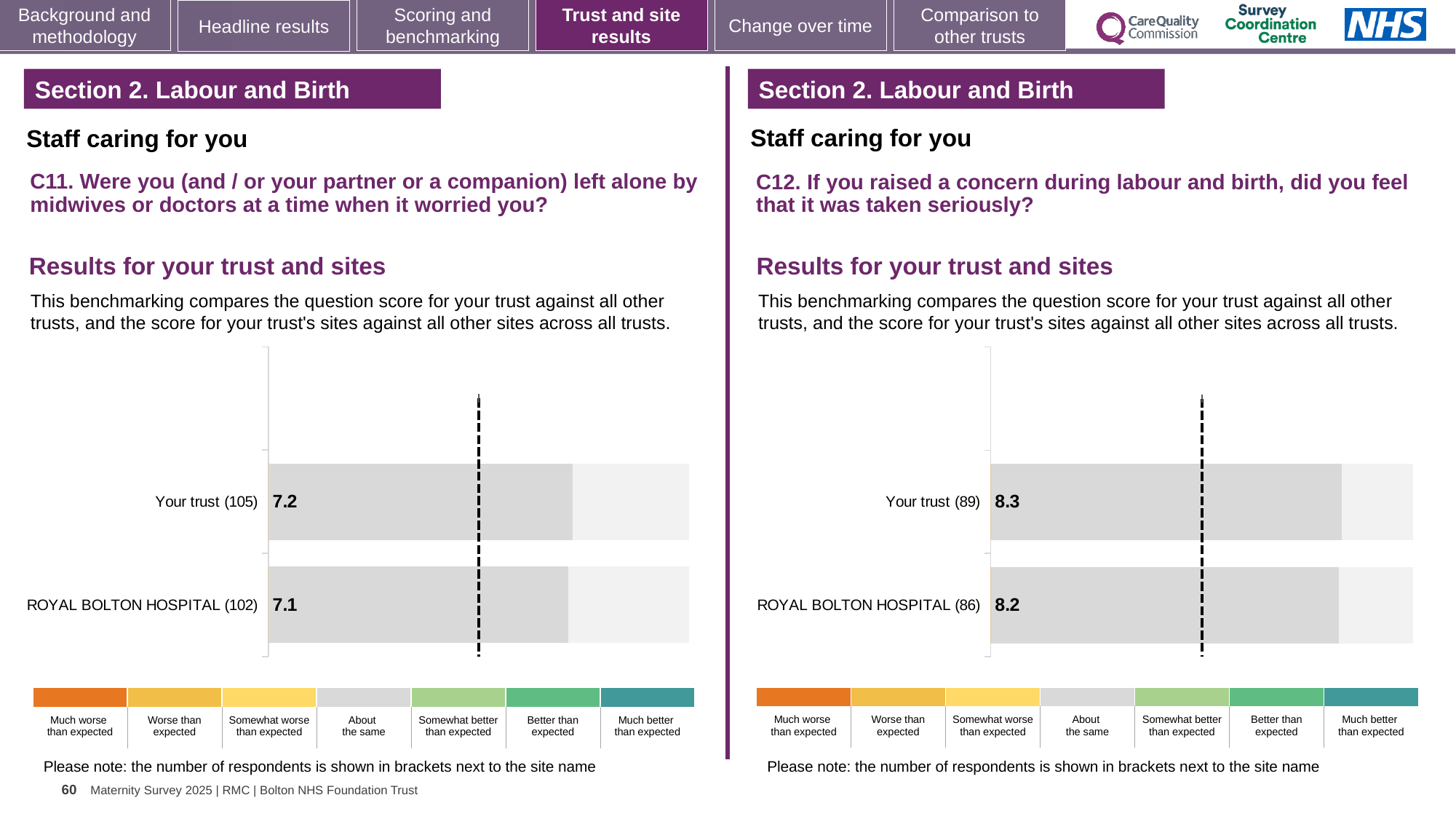
In the C11 chart on the left, how many respondents are shown in brackets for Your trust? 105 In the C12 chart on the right, what is the score for ROYAL BOLTON HOSPITAL? 8.2 In the C12 chart on the right, which row has the lower score? ROYAL BOLTON HOSPITAL In the C11 chart on the left, what is the score for Your trust? 7.2 How many bars are plotted in the C12 chart on the right? 2 In the C12 chart on the right, is the score for Your trust larger or smaller than the score for ROYAL BOLTON HOSPITAL? larger In the C11 chart on the left, what is the score for ROYAL BOLTON HOSPITAL? 7.1 In the C11 chart on the left, what is the difference between the Your trust score and the ROYAL BOLTON HOSPITAL score? 0.1 What type of chart is used in the C11 chart on the left? bar chart In the C12 chart on the right, what is the score for Your trust? 8.3 In the C11 chart on the left, which row has the higher score? Your trust In the C12 chart on the right, how many respondents are shown in brackets for ROYAL BOLTON HOSPITAL? 86